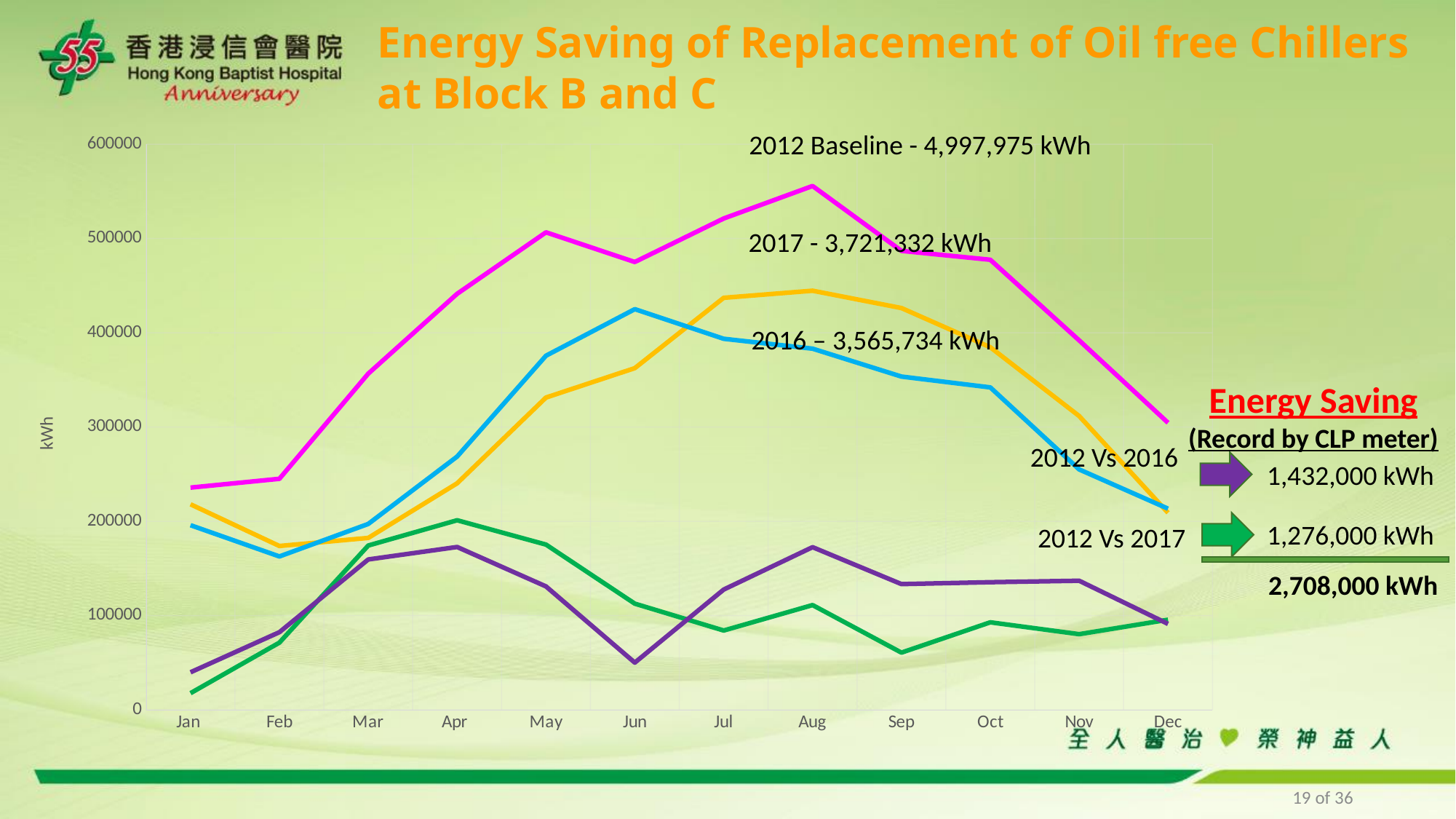
What kind of chart is shown on the slide? line chart How many months are shown along the x axis of the chart? 12 Which annual total is larger, 2016 or 2017? 2017 In which month does the 2012 Baseline line reach its highest value? Aug What is the combined energy saving shown below the two arrows? 2,708,000 kWh What is the label on the y axis of the chart? kWh What is the 2012 Baseline total annotated on the chart? 4,997,975 kWh What is the 2016 total annotated on the chart? 3,565,734 kWh What is the energy saving for 2012 Vs 2016? 1,432,000 kWh What is the difference between the 2012 Vs 2016 saving and the 2012 Vs 2017 saving? 156,000 kWh What is the 2017 total annotated on the chart? 3,721,332 kWh Is the 2012 Baseline value in Aug greater or less than 500000? greater